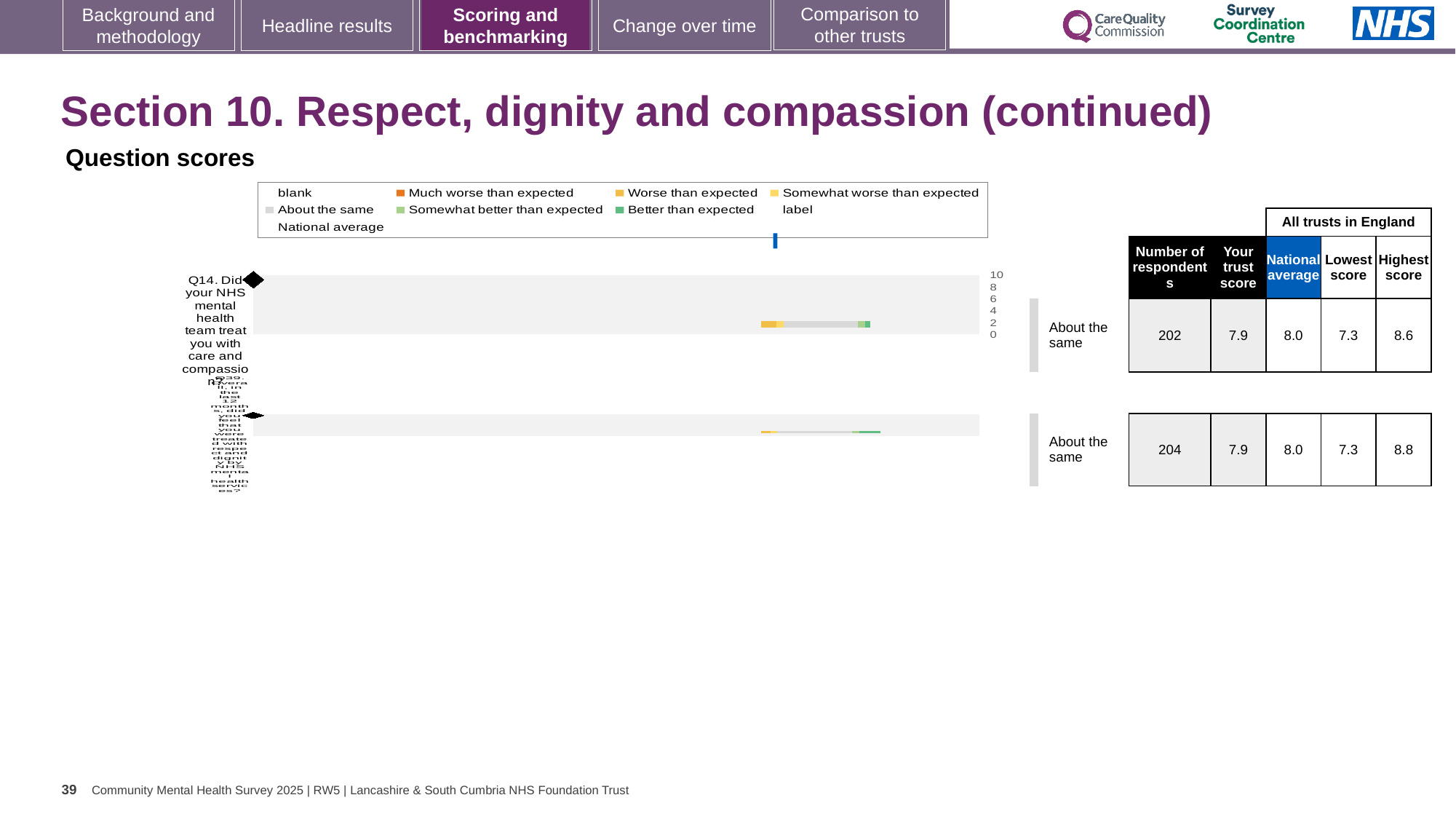
How many respondents are shown for Q39 (the second question row)? 204 What kind of chart is used to show the question scores on this slide? bar chart What is the lowest score among all trusts in England for Q14? 7.3 What benchmark category is shown for Q14? About the same How many question rows are plotted in the question scores chart? 2 Which question has the higher 'Highest score' across all trusts in England, Q14 or Q39? Q39 How many respondents are shown for Q14? 202 What is the highest score among all trusts in England for Q39 (the second question row)? 8.8 What does the dark blue marker in the chart legend represent? National average What is the difference between the highest score and the lowest score for Q14? 1.3 What is the 'Your trust score' for Q14 (Did your NHS mental health team treat you with care and compassion?)? 7.9 What is the national average score for Q14? 8.0